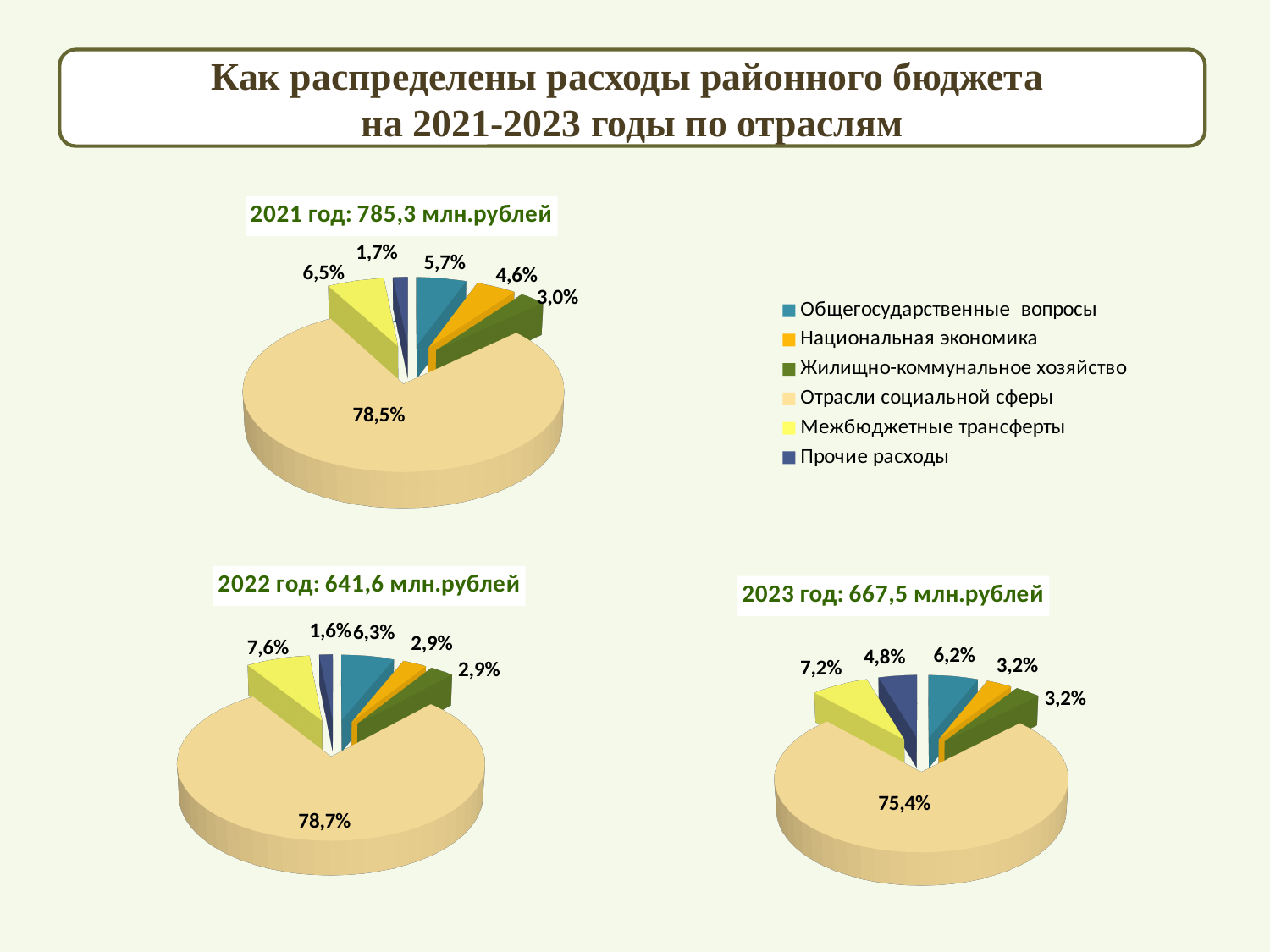
What total amount is stated in the title of the 2023 chart? 667,5 млн.рублей How many pie charts are shown on the slide? 3 On the 2021 pie chart, what share is labelled for Отрасли социальной сферы? 78,5% On the 2021 pie chart, what share is labelled for Межбюджетные трансферты? 6,5% How many categories does the legend list? 6 What kind of chart is used for the 2022 data? Pie chart On the 2023 pie chart, which is larger: the share of Межбюджетные трансферты or the share of Общегосударственные вопросы? Межбюджетные трансферты On the 2021 pie chart, what is the difference between the shares of Общегосударственные вопросы and Национальная экономика? 1,1% On the 2022 pie chart, what share is labelled for Общегосударственные вопросы? 6,3% On the 2022 pie chart, which category has the smallest share? Прочие расходы On the 2023 pie chart, which category has the largest share? Отрасли социальной сферы On the 2023 pie chart, what share is labelled for Прочие расходы? 4,8%